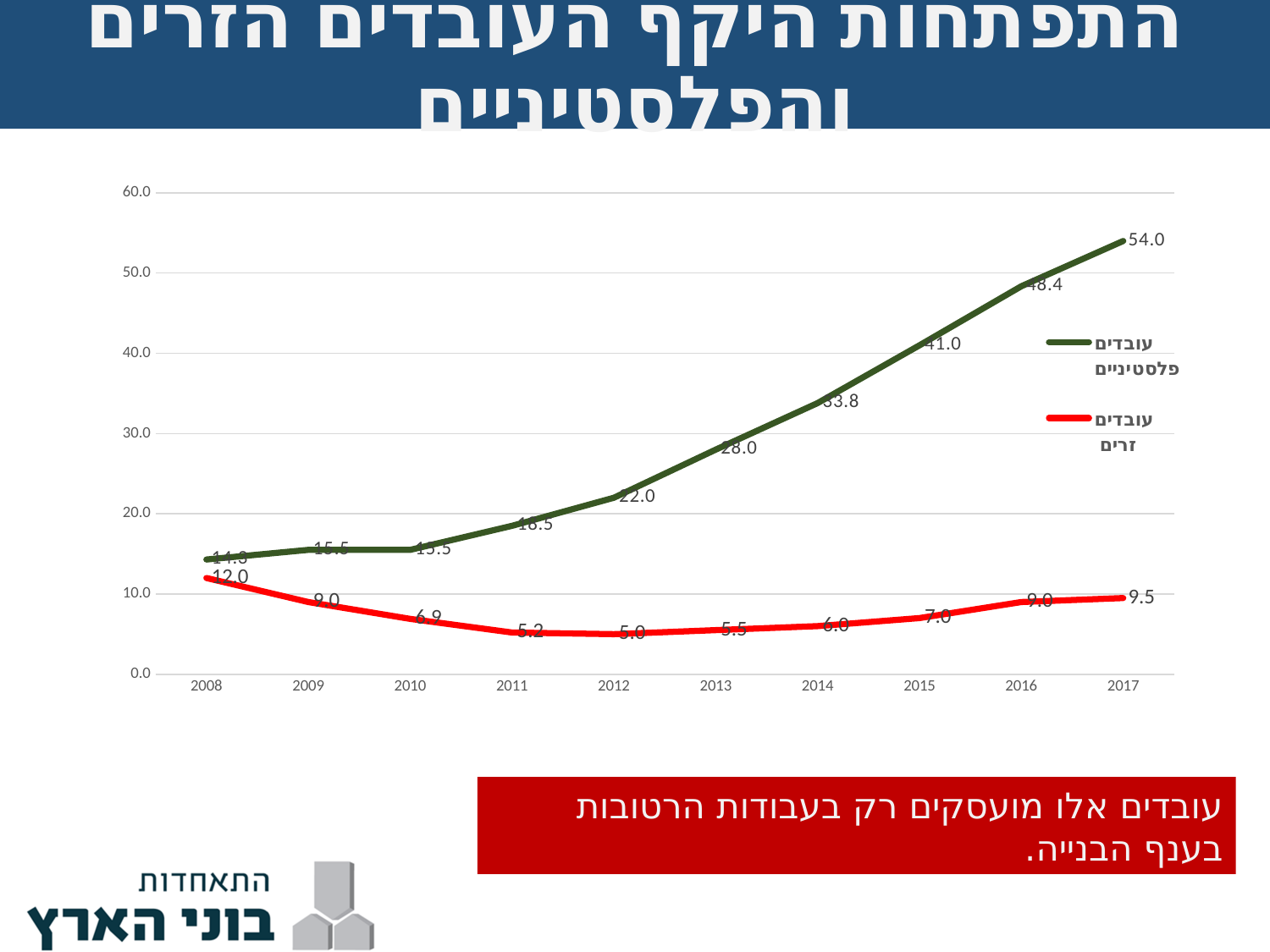
What is the difference between the 2017 values of עובדים פלסטיניים (54.0) and עובדים זרים (9.5)? 44.5 In which year is the value for עובדים פלסטיניים (Palestinian workers) highest? 2017 What type of chart is shown on the slide? Line chart What is the value for עובדים פלסטיניים (Palestinian workers) in 2014? 33.8 What is the value for עובדים פלסטיניים (Palestinian workers) in 2017? 54.0 Which series has the larger value in 2008, עובדים פלסטיניים or עובדים זרים? עובדים פלסטיניים In which year is the value for עובדים זרים (foreign workers) lowest? 2012 Is the value for עובדים פלסטיניים (Palestinian workers) in 2016 greater or less than 40.0? greater What is the value for עובדים זרים (foreign workers) in 2012? 5.0 Does the value for עובדים פלסטיניים (Palestinian workers) rise or fall from 2012 to 2017? Rise How many series does the legend list? 2 How many years are shown on the x axis? 10